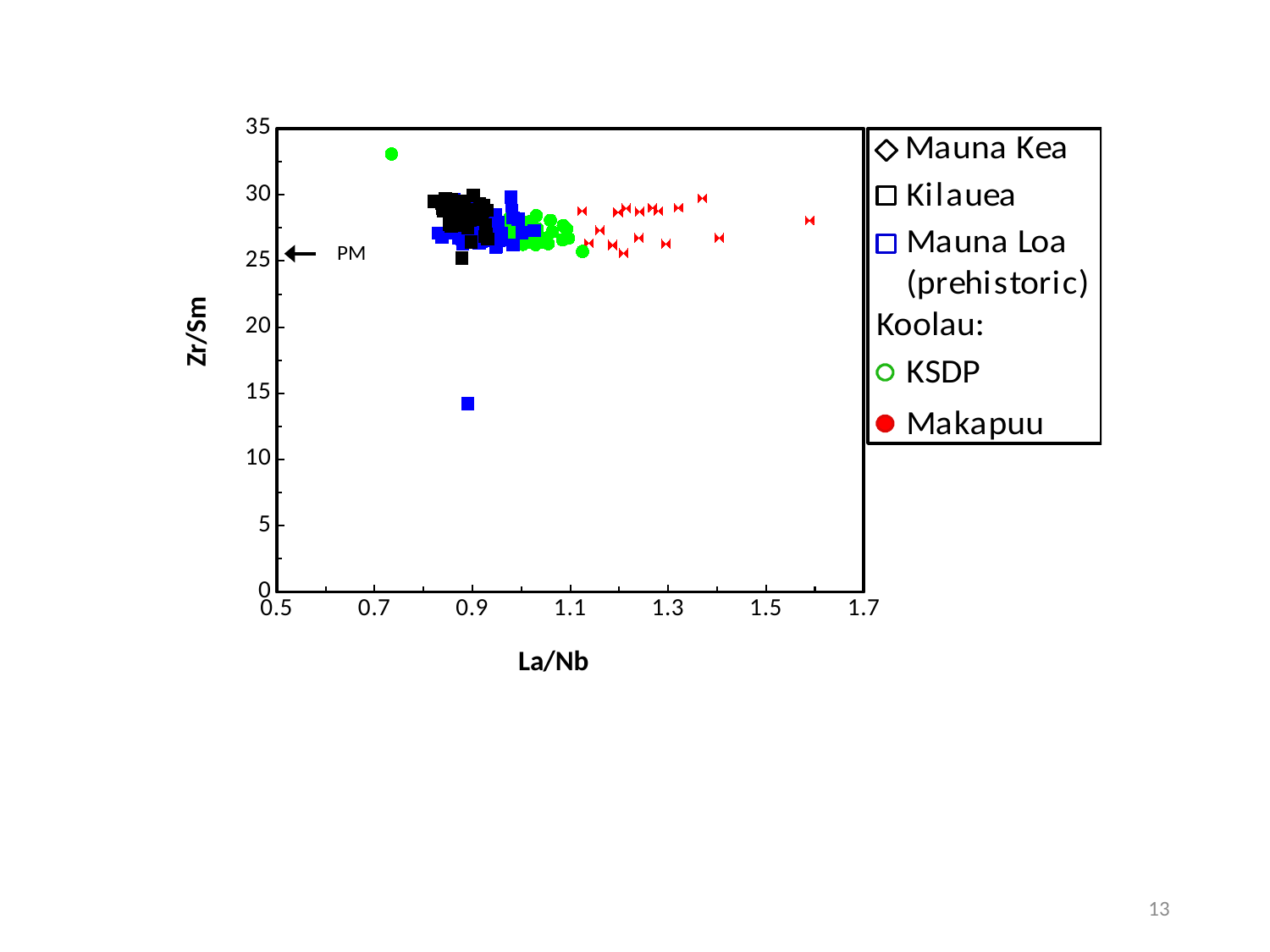
Which series extends to the highest La/Nb values? Makapuu Which series has the point with the lowest Zr/Sm value? Mauna Loa (prehistoric) Which series has a higher maximum La/Nb value, Kilauea or Makapuu? Makapuu How many series does the legend list? 5 What is the label of the y axis? Zr/Sm Is the Zr/Sm value of the highest KSDP point greater or less than 30? greater What is the label of the x axis? La/Nb Which series has the point with the highest Zr/Sm value? KSDP Is the La/Nb value of the rightmost Makapuu point greater or less than 1.5? greater What kind of chart is shown on the slide? Scatter plot Is the Zr/Sm value of the lowest Mauna Loa (prehistoric) point greater or less than 20? less What is the maximum value shown on the x axis? 1.7